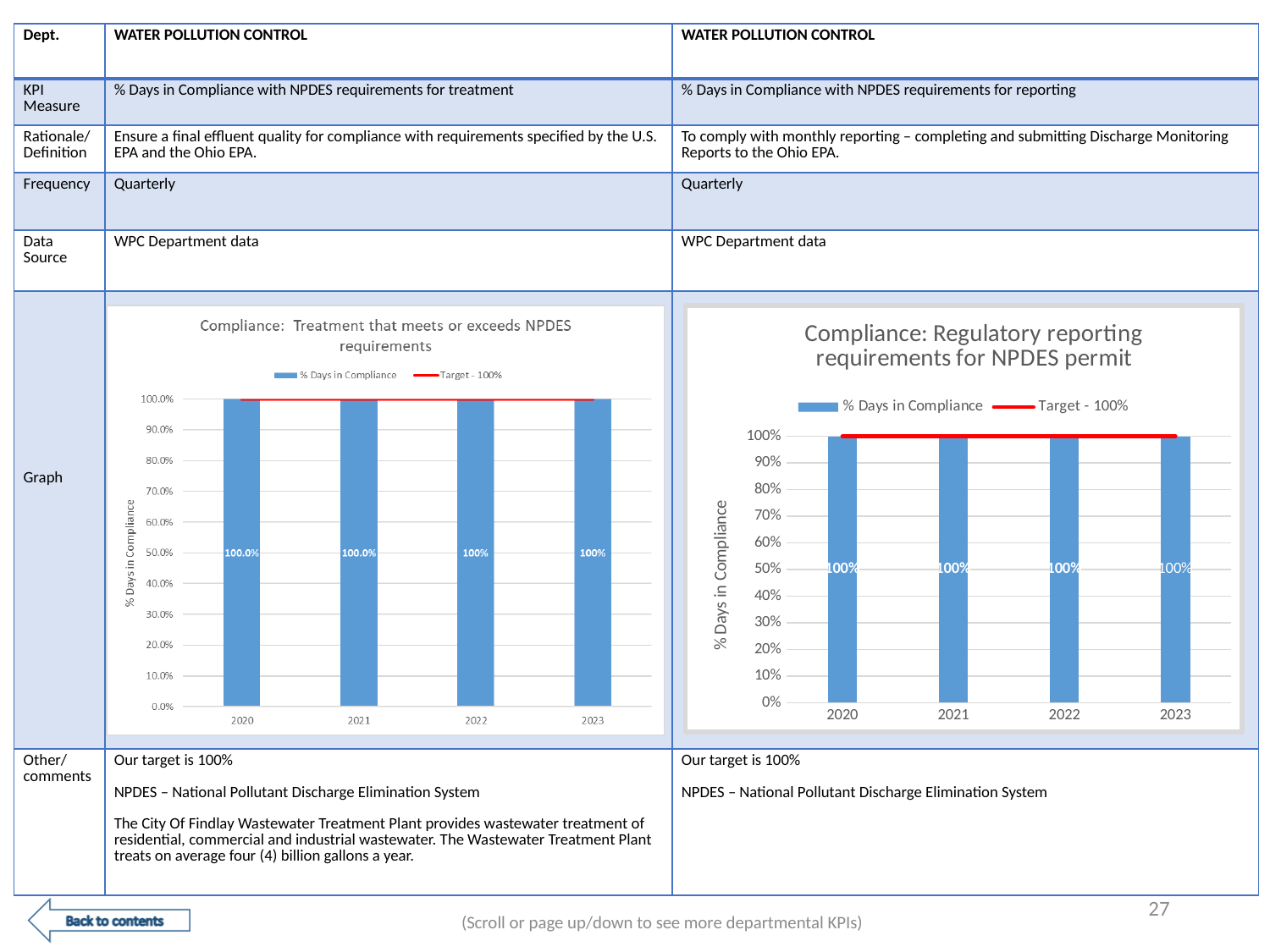
In the right chart, 'Compliance: Regulatory reporting requirements for NPDES permit', what is the value for 2023? 100% What is the y-axis label of the right chart, 'Compliance: Regulatory reporting requirements for NPDES permit'? % Days in Compliance In the left chart, 'Compliance: Treatment that meets or exceeds NPDES requirements', what is the difference between the 2020 and 2021 values? 0.0% What does the red line in the left chart, 'Compliance: Treatment that meets or exceeds NPDES requirements', represent according to the legend? Target - 100% In the right chart, 'Compliance: Regulatory reporting requirements for NPDES permit', do the values rise, fall or stay the same from 2020 to 2023? Stay the same How many series does the legend of the right chart, 'Compliance: Regulatory reporting requirements for NPDES permit', list? 2 In the left chart, 'Compliance: Treatment that meets or exceeds NPDES requirements', what is the value for 2022? 100% What kind of chart is the left chart, 'Compliance: Treatment that meets or exceeds NPDES requirements'? Bar chart In the left chart, 'Compliance: Treatment that meets or exceeds NPDES requirements', what is the value for 2020? 100.0% In the right chart, 'Compliance: Regulatory reporting requirements for NPDES permit', what is the value for 2021? 100% How many years are shown on the x axis of the right chart, 'Compliance: Regulatory reporting requirements for NPDES permit'? 4 How many years are shown on the x axis of the left chart, 'Compliance: Treatment that meets or exceeds NPDES requirements'? 4